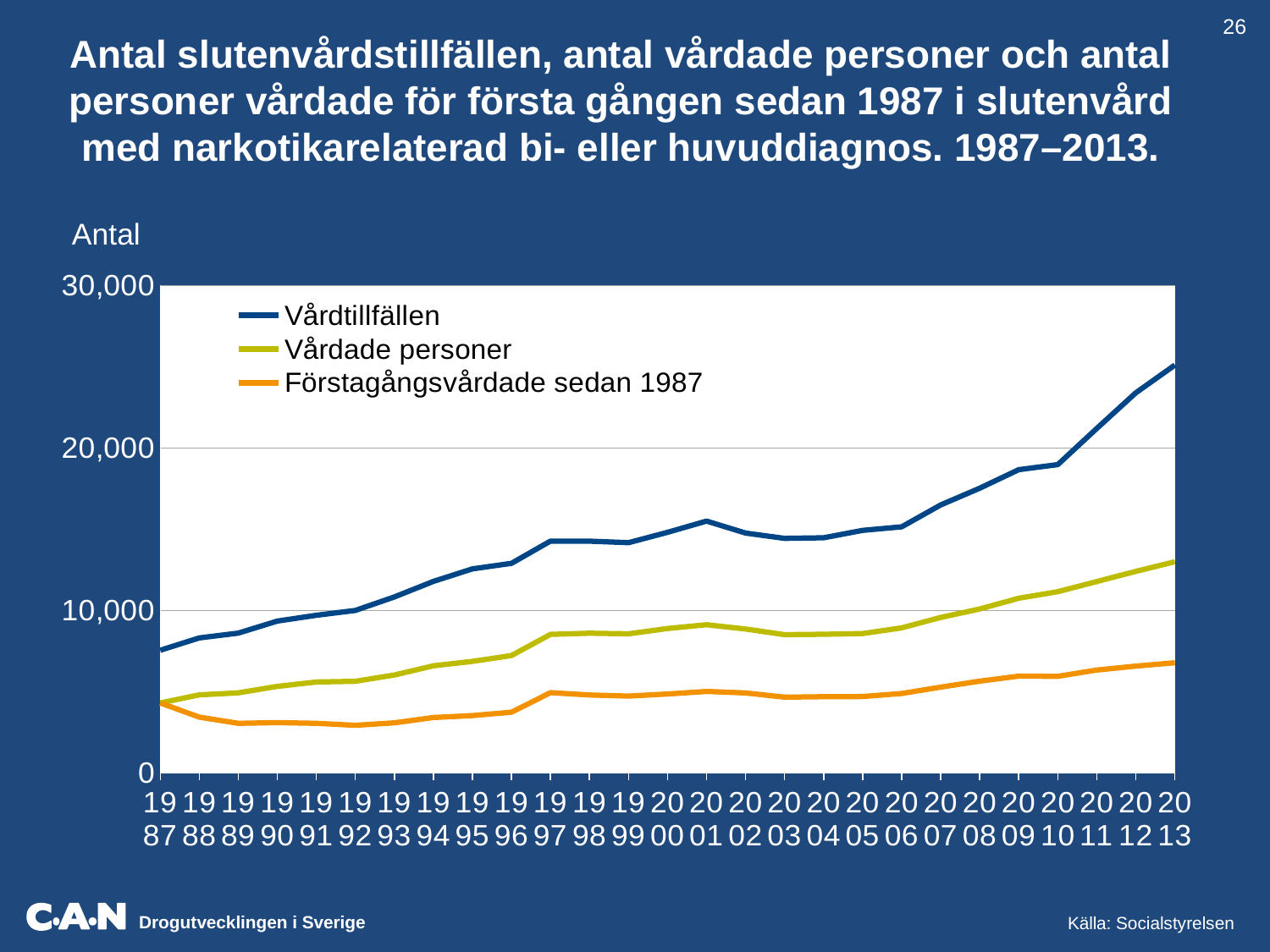
What kind of chart is shown on the slide? line chart Is the value for Vårdtillfällen in 2001 greater or less than 20,000? less Is the value for Vårdade personer in 2013 greater or less than 10,000? greater How many years are plotted along the x axis? 27 Is the value for Vårdtillfällen in 1987 greater or less than 10,000? less In which year is the Vårdtillfällen series at its lowest? 1987 How many series does the legend list? 3 In 2013, which is larger: Vårdtillfällen or Vårdade personer? Vårdtillfällen In which year is the Vårdtillfällen series at its highest? 2013 Does the Vårdtillfällen series generally rise or fall from 1987 to 2013? rise